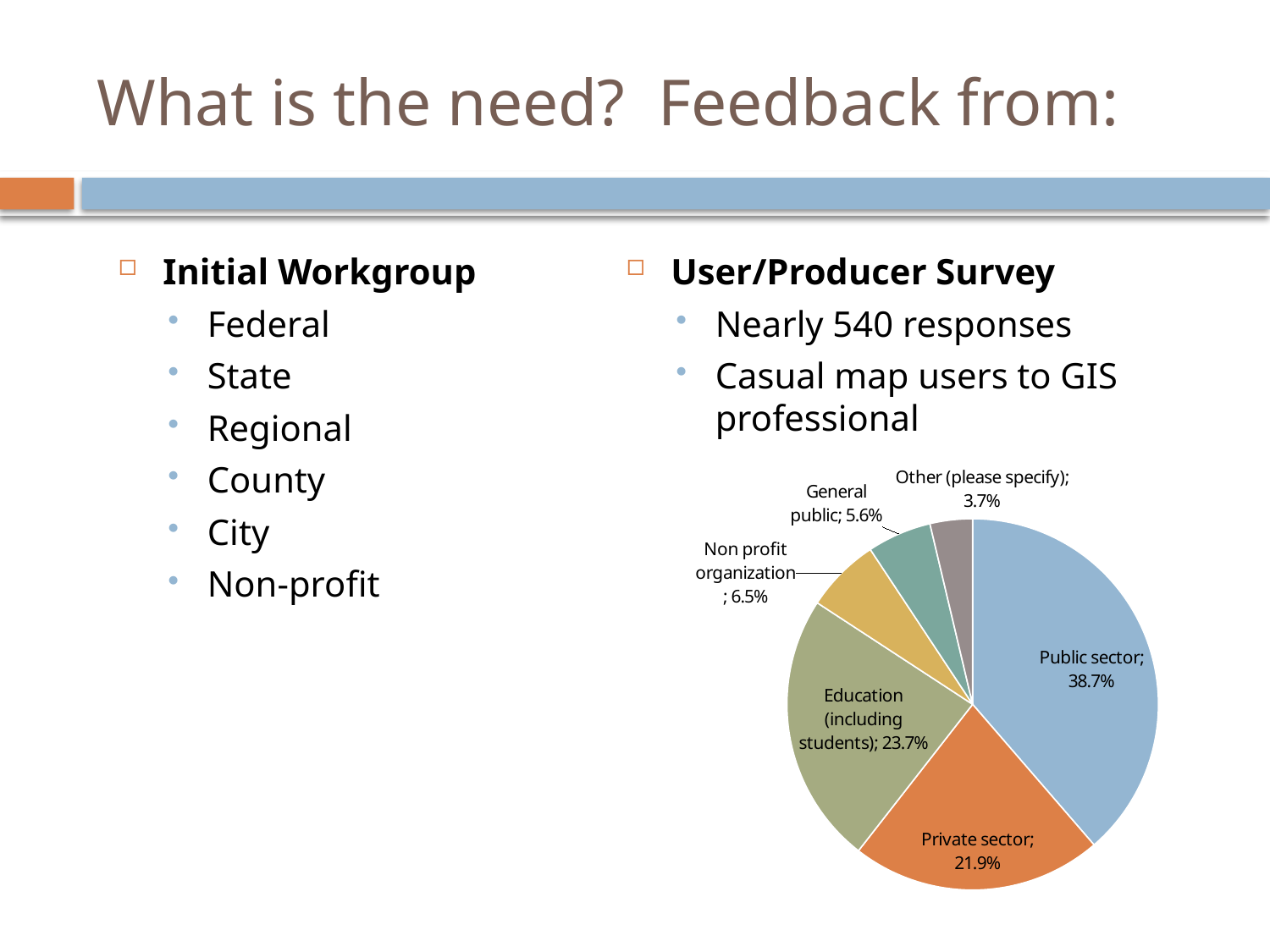
What is the value for Education (including students)? 23.7% What share of the pie does Public sector have? 38.7% Which is larger, Education (including students) or Private sector? Education (including students) What is the value for Private sector? 21.9% What is the value for General public? 5.6% Which category has the smallest slice of the pie? Other (please specify) What kind of chart is shown on the slide? Pie chart What is the value for Non profit organization? 6.5% What is the difference between the Public sector and Private sector shares? 16.8% How many slices does the pie chart have? 6 What colour is the Public sector slice? Blue Which category has the largest slice of the pie? Public sector